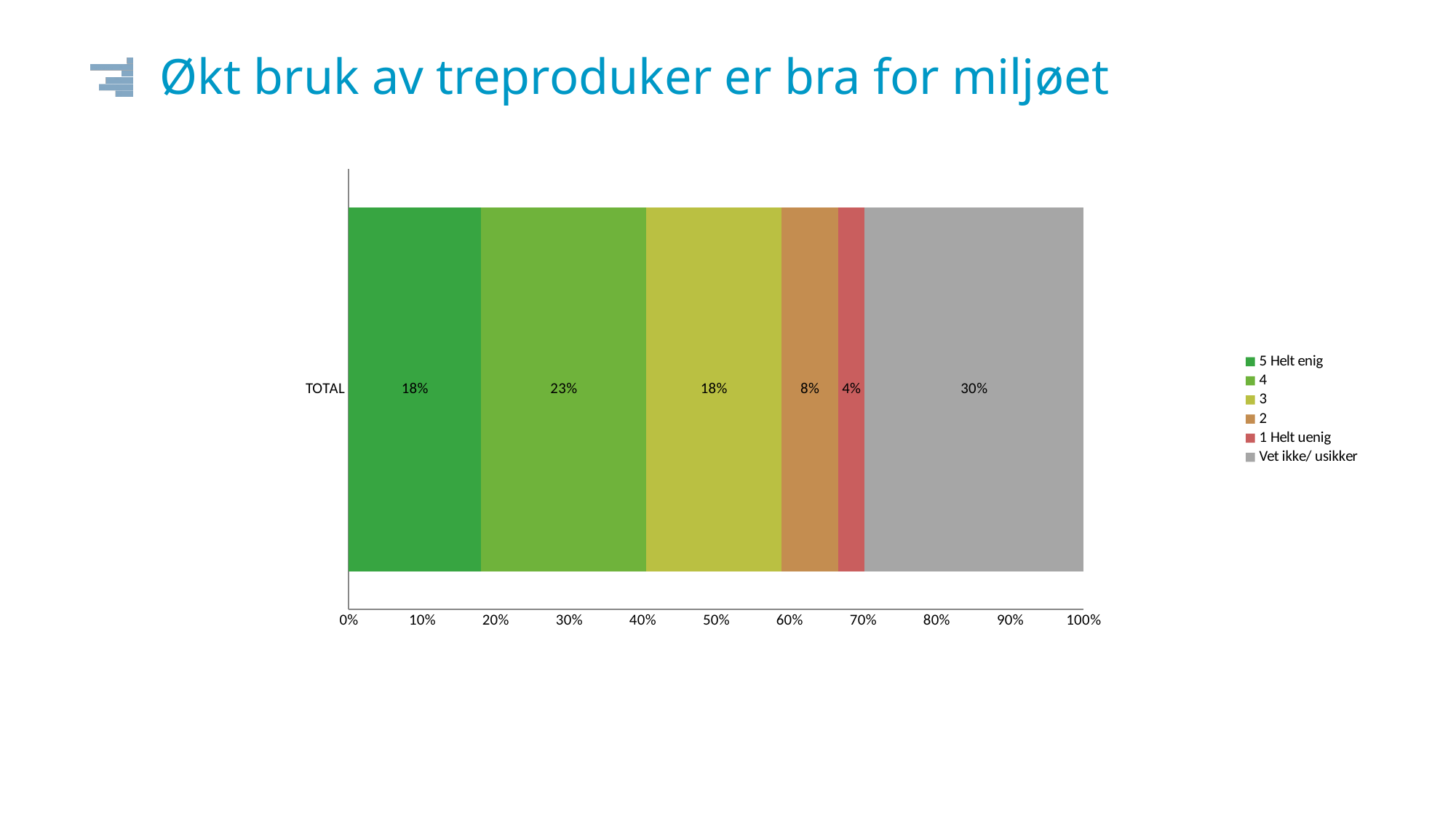
Which is larger, the "Vet ikke/ usikker" segment or the "4" segment? Vet ikke/ usikker What share of the TOTAL bar is "Vet ikke/ usikker"? 30% What is the value for "1 Helt uenig"? 4% Which response category has the largest share of the TOTAL bar? Vet ikke/ usikker What is the difference between the "4" segment and the "2" segment? 15% What is the value for the "2" segment? 8% What kind of chart is shown on the slide? Stacked bar chart What is the value for the "4" segment of the TOTAL bar? 23% How many series does the legend list? 6 What percentage of respondents answered "5 Helt enig"? 18% Which response category has the smallest share of the TOTAL bar? 1 Helt uenig What is the title of the slide? Økt bruk av treproduker er bra for miljøet